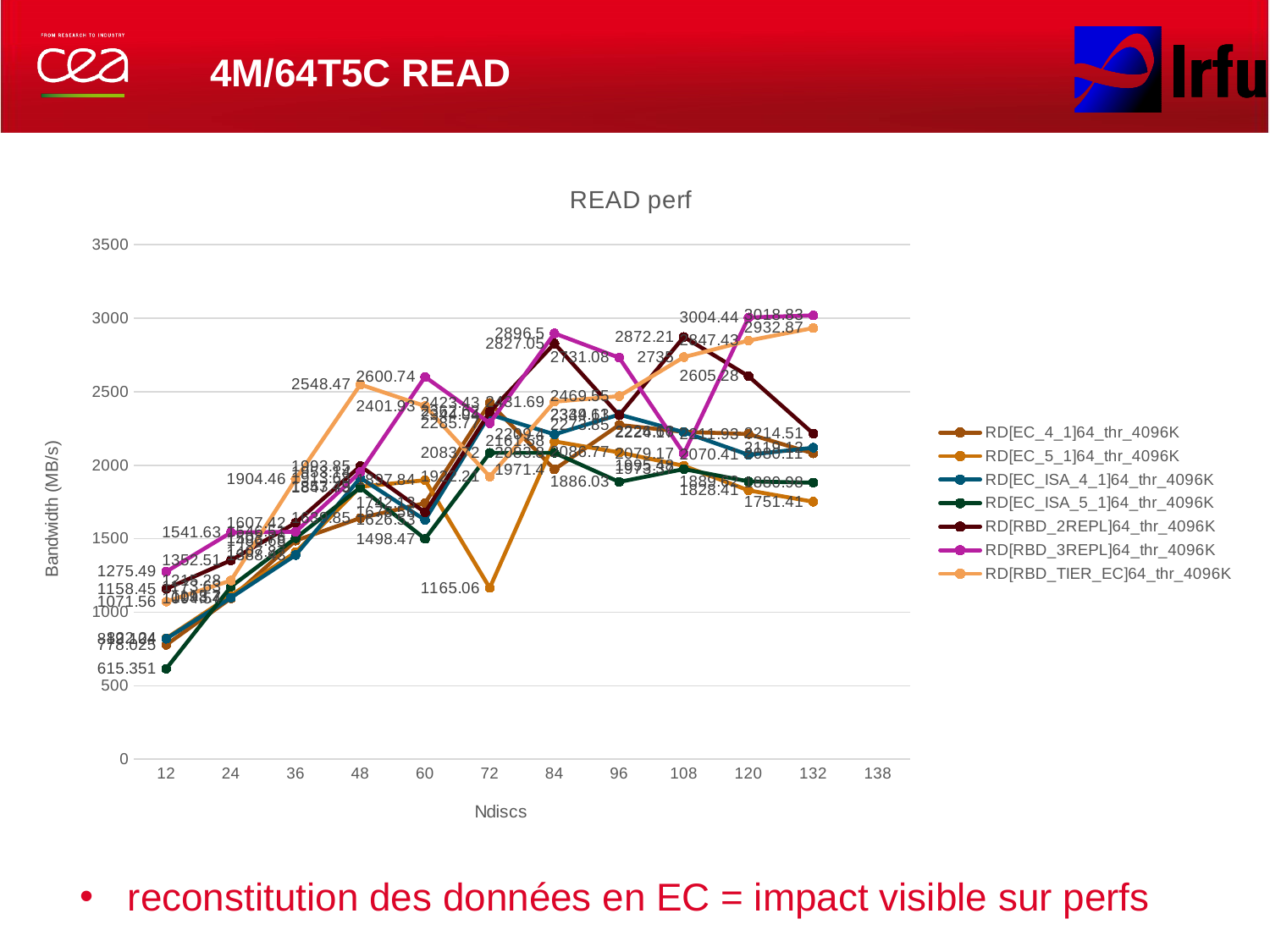
What is the y-axis label of the chart? Bandwidth (MB/s) Does RD[EC_ISA_5_1]64_thr_4096K rise or fall from 12 to 48 discs? rise What is the value of RD[EC_5_1]64_thr_4096K at 132 discs? 1751.41 At 12 discs, which is larger: RD[RBD_3REPL]64_thr_4096K or RD[EC_ISA_5_1]64_thr_4096K? RD[RBD_3REPL]64_thr_4096K Which series has the lowest value at 12 discs? RD[EC_ISA_5_1]64_thr_4096K What is the value of RD[EC_ISA_5_1]64_thr_4096K at 12 discs? 615.351 What is the value of RD[EC_5_1]64_thr_4096K at 72 discs? 1165.06 What is the value of RD[RBD_TIER_EC]64_thr_4096K at 132 discs? 2932.87 What kind of chart is shown on the slide? line chart Is the value of RD[EC_5_1]64_thr_4096K at 72 discs greater or less than 1500? less What is the title of the chart? READ perf How many series does the legend of the READ perf chart list? 7